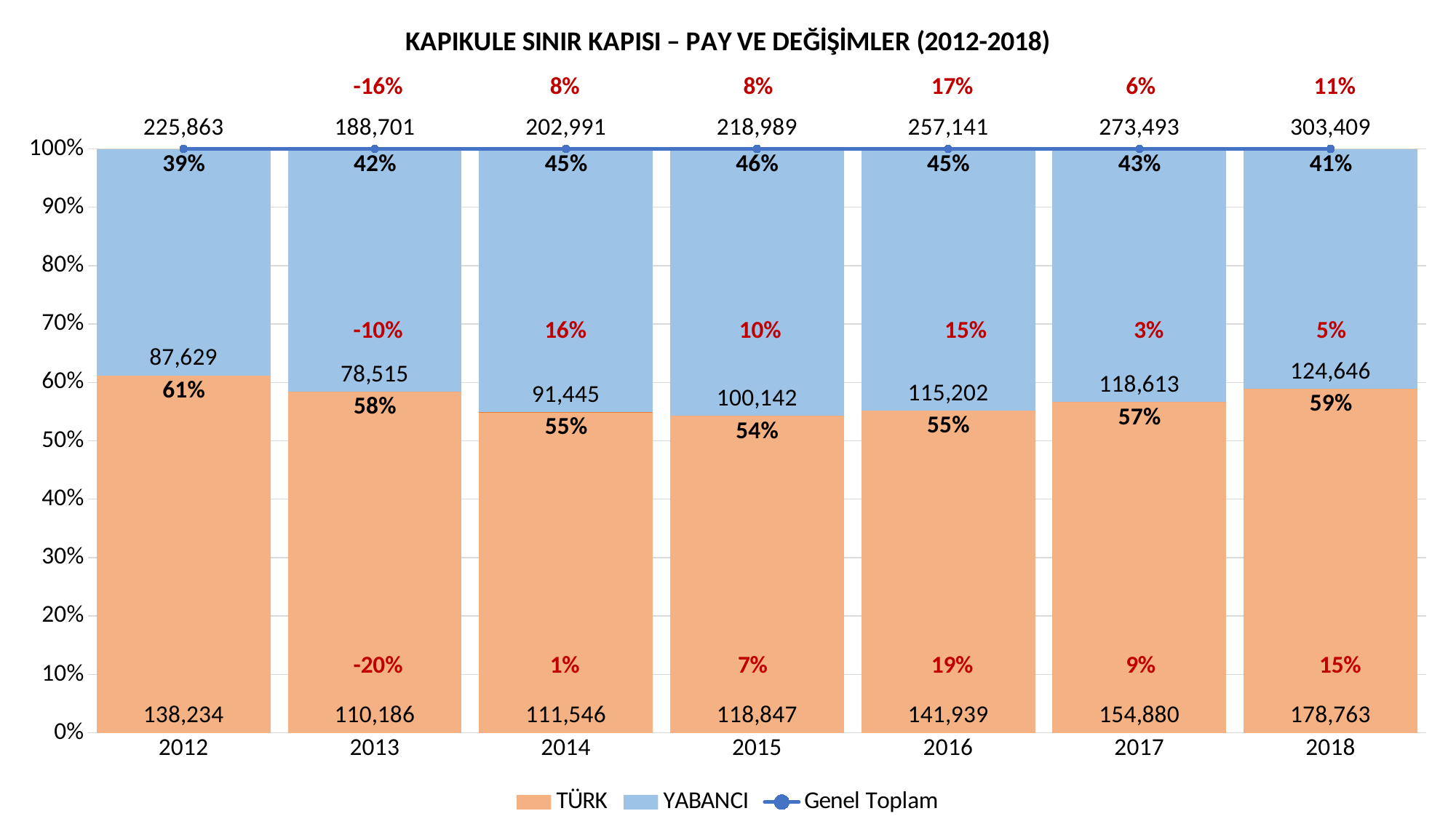
In which year is the TÜRK value lowest? 2013 What is the difference between the TÜRK values for 2018 and 2017? 23,883 What is the percentage change shown in red for Genel Toplam in 2013? -16% What is the Genel Toplam value for 2016? 257,141 What is the YABANCI value for 2018? 124,646 In which year is the Genel Toplam value highest? 2018 What percentage share does TÜRK have in 2015? 54% Which year has the larger YABANCI value, 2016 or 2017? 2017 What is the TÜRK value for 2012? 138,234 How many series does the legend list? 3 How many years are shown on the x axis? 7 What kind of chart is this? Stacked bar chart with a line